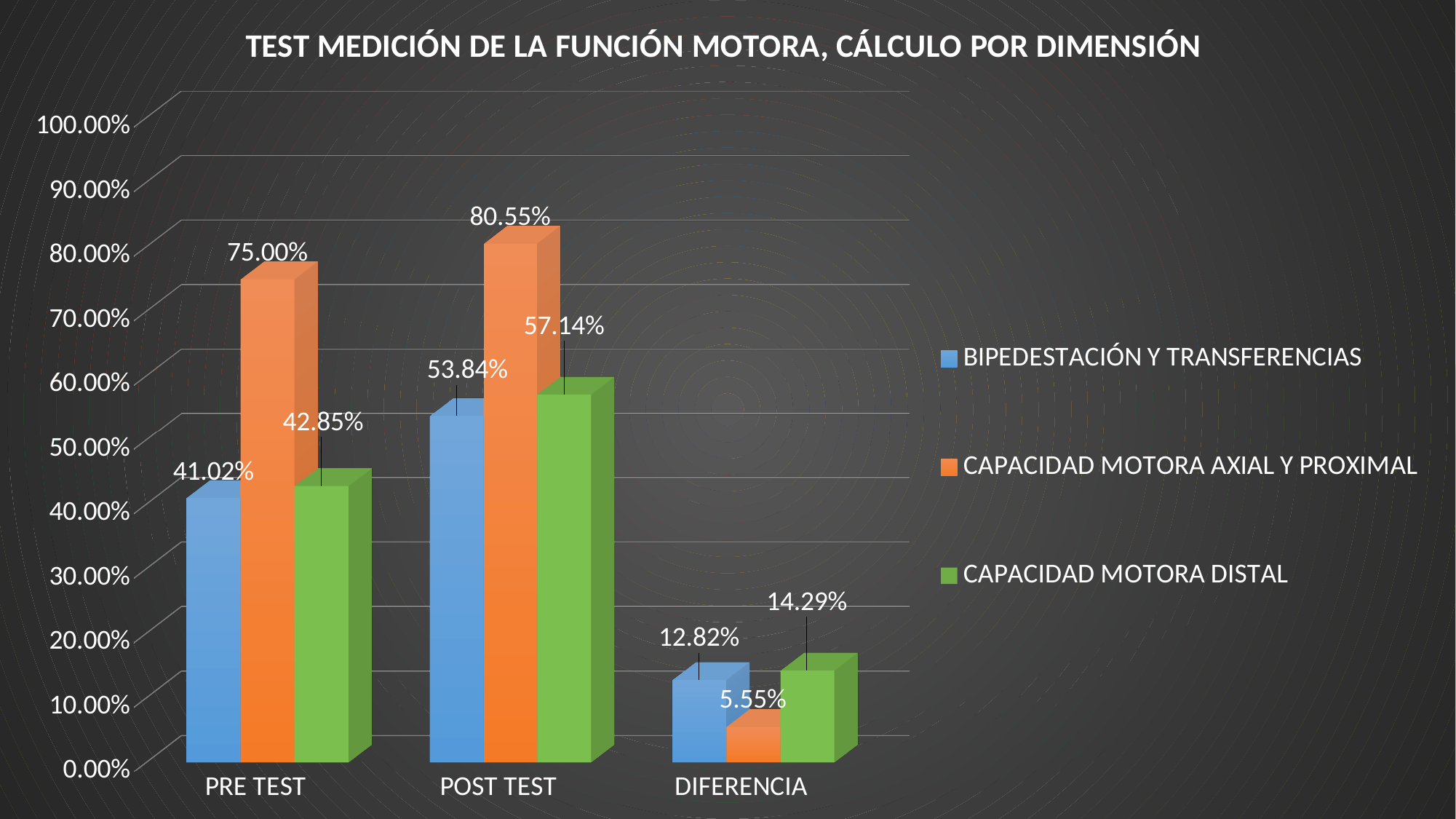
Which is larger in the PRE TEST category: BIPEDESTACIÓN Y TRANSFERENCIAS or CAPACIDAD MOTORA DISTAL? CAPACIDAD MOTORA DISTAL What is the value for CAPACIDAD MOTORA AXIAL Y PROXIMAL in the PRE TEST category? 75.00% How many categories are shown on the x axis? 3 What kind of chart is shown on the slide? Bar chart Which series has the lowest value in the DIFERENCIA category? CAPACIDAD MOTORA AXIAL Y PROXIMAL How many series does the legend list? 3 Is the value for CAPACIDAD MOTORA AXIAL Y PROXIMAL in the POST TEST category greater or less than 80.00%? greater What is the value for CAPACIDAD MOTORA DISTAL in the DIFERENCIA category? 14.29% Which series has the highest value in the POST TEST category? CAPACIDAD MOTORA AXIAL Y PROXIMAL What is the difference between the POST TEST and PRE TEST values for CAPACIDAD MOTORA DISTAL? 14.29% What is the title of the chart? TEST MEDICIÓN DE LA FUNCIÓN MOTORA, CÁLCULO POR DIMENSIÓN What is the value for BIPEDESTACIÓN Y TRANSFERENCIAS in the POST TEST category? 53.84%